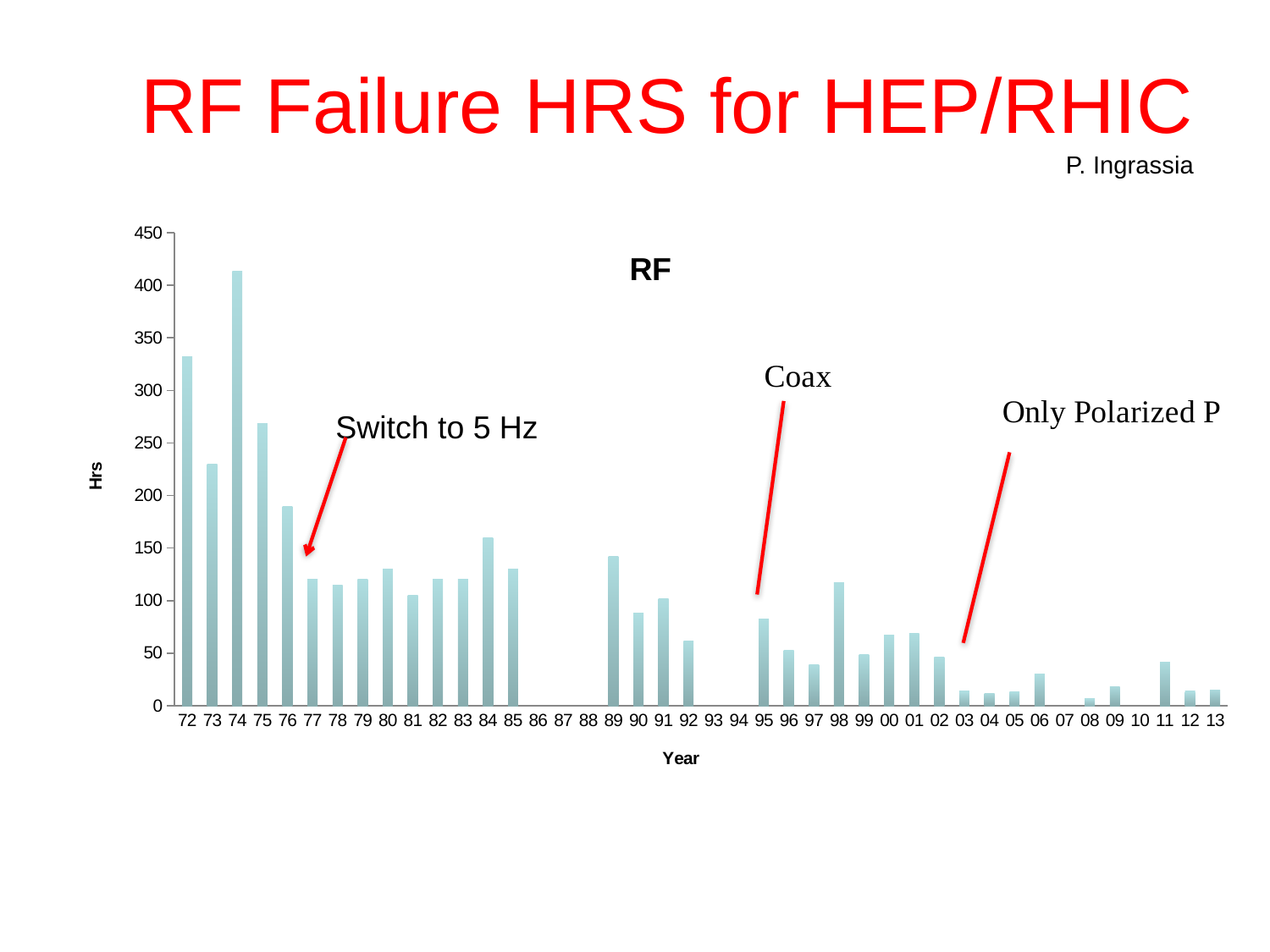
Is the value for 72 greater or less than 300? greater Is the value for 74 greater or less than 400? greater Which year has the highest RF failure hours? 74 Which is larger, the value for 84 or the value for 85? 84 What is the label on the y axis of the chart? Hrs Is the value for 95 greater or less than 100? less Overall, do the RF failure hours rise or fall from 72 to 13? fall Which is larger, the value for 72 or the value for 73? 72 What kind of chart is shown on the slide? bar chart How many year categories are shown on the x axis? 42